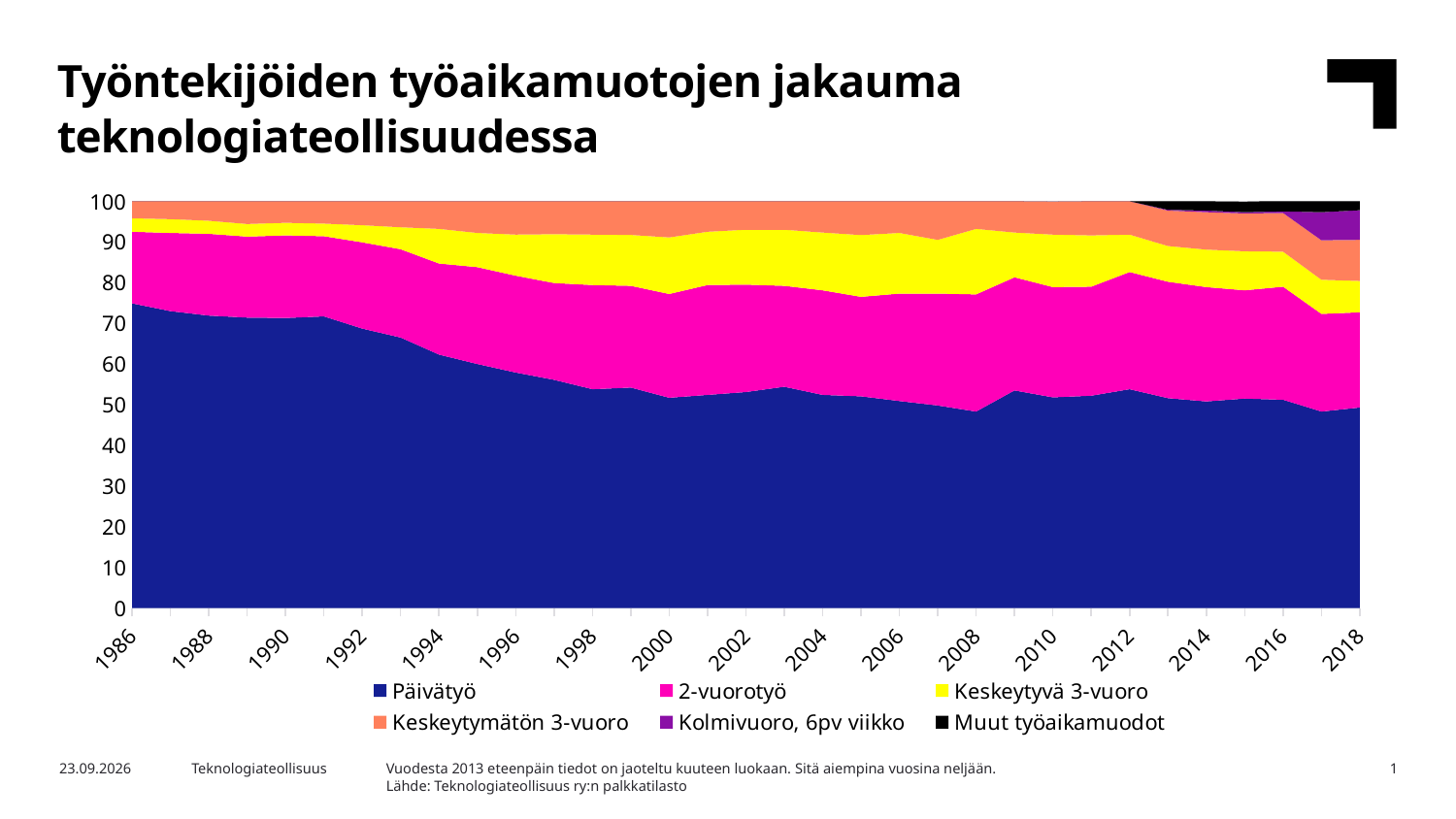
Is the value for Päivätyö in 1994 greater or less than 60? greater Is the share of Päivätyö larger in 1986 or in 2018? 1986 Is the value for Päivätyö in 2018 greater or less than 60? less In 1986, which series has the larger share: Päivätyö or 2-vuorotyö? Päivätyö How many series does the legend list? 6 Is the cumulative top of the 2-vuorotyö band in 1986 greater or less than 90? greater What kind of chart is shown on the slide? Stacked area chart Does the share of Päivätyö rise or fall from 1986 to 2018? Fall Which series is shown in black in the legend? Muut työaikamuodot What is the title of the chart? Työntekijöiden työaikamuotojen jakauma teknologiateollisuudessa